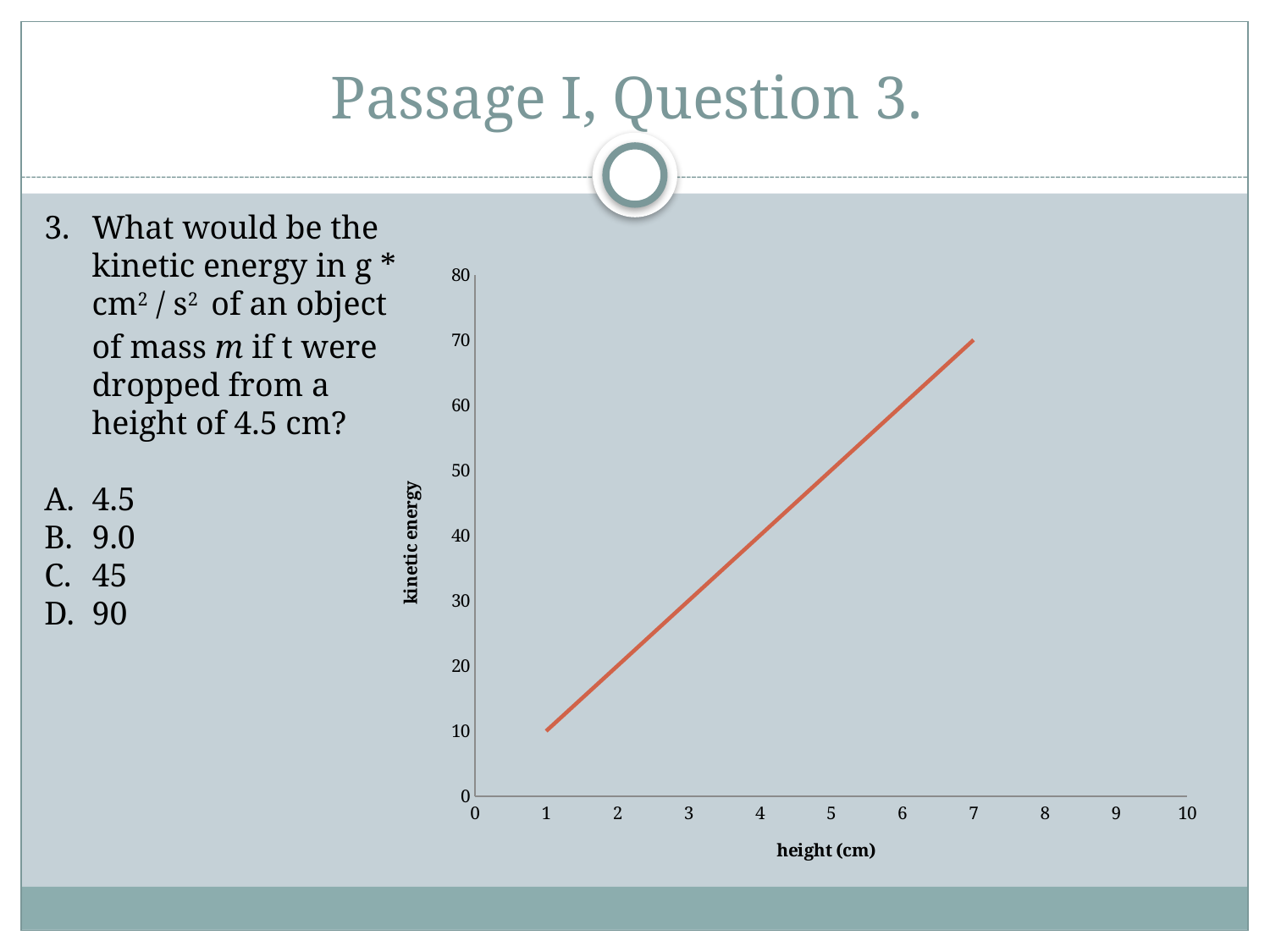
Does kinetic energy rise or fall as height increases along the x axis? rise Which height has the larger kinetic energy, 1 cm or 7 cm? 7 cm Is the kinetic energy at a height of 4 cm greater or less than 30? greater What is the difference in kinetic energy between a height of 7 cm and a height of 1 cm? 60 What is the label of the y axis of the chart? kinetic energy What is the highest value shown on the y axis of the chart? 80 Is the kinetic energy at a height of 3 cm greater or less than 20? greater What kind of chart is shown on the slide? line chart What is the kinetic energy at a height of 7 cm, where the line ends? 70 What is the label of the x axis of the chart? height (cm) What is the kinetic energy at a height of 1 cm, where the line begins? 10 Is the kinetic energy at a height of 5 cm greater or less than 60? less